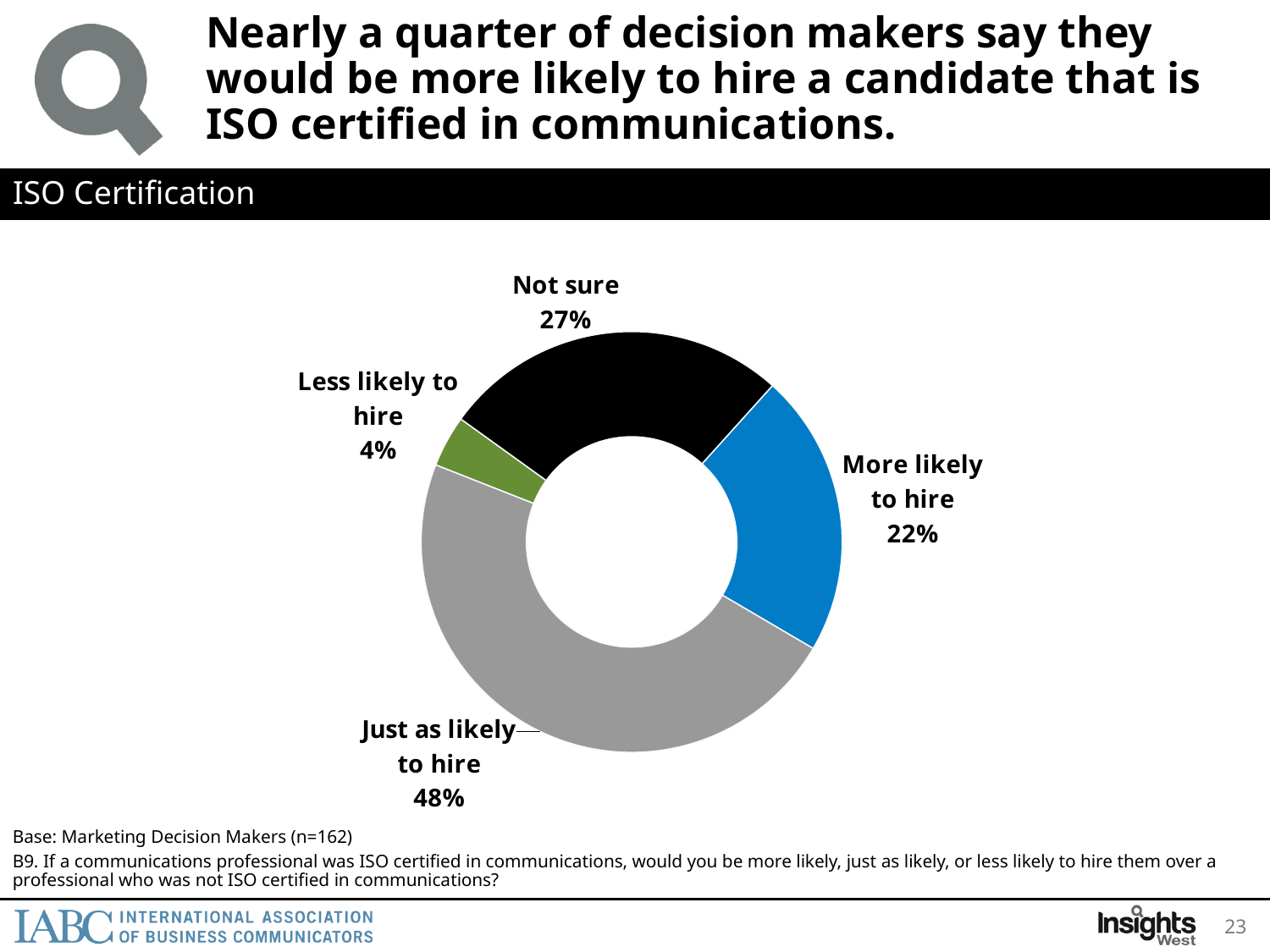
What percentage of respondents are 'Not sure'? 27% What percentage of decision makers say they would be more likely to hire an ISO certified candidate? 22% What percentage of respondents say they would be 'Just as likely to hire'? 48% What type of chart is shown on the slide? Doughnut chart How many response categories are shown in the chart? 4 What is the difference in percentage points between 'Just as likely to hire' and 'More likely to hire'? 26 What colour is the 'More likely to hire' segment? Blue What percentage of respondents say they would be 'Less likely to hire'? 4% What is the base sample size stated below the chart? n=162 Which response category has the smallest share of the chart? Less likely to hire Which response category has the largest share of the chart? Just as likely to hire Which is larger: the share for 'Not sure' or the share for 'More likely to hire'? Not sure